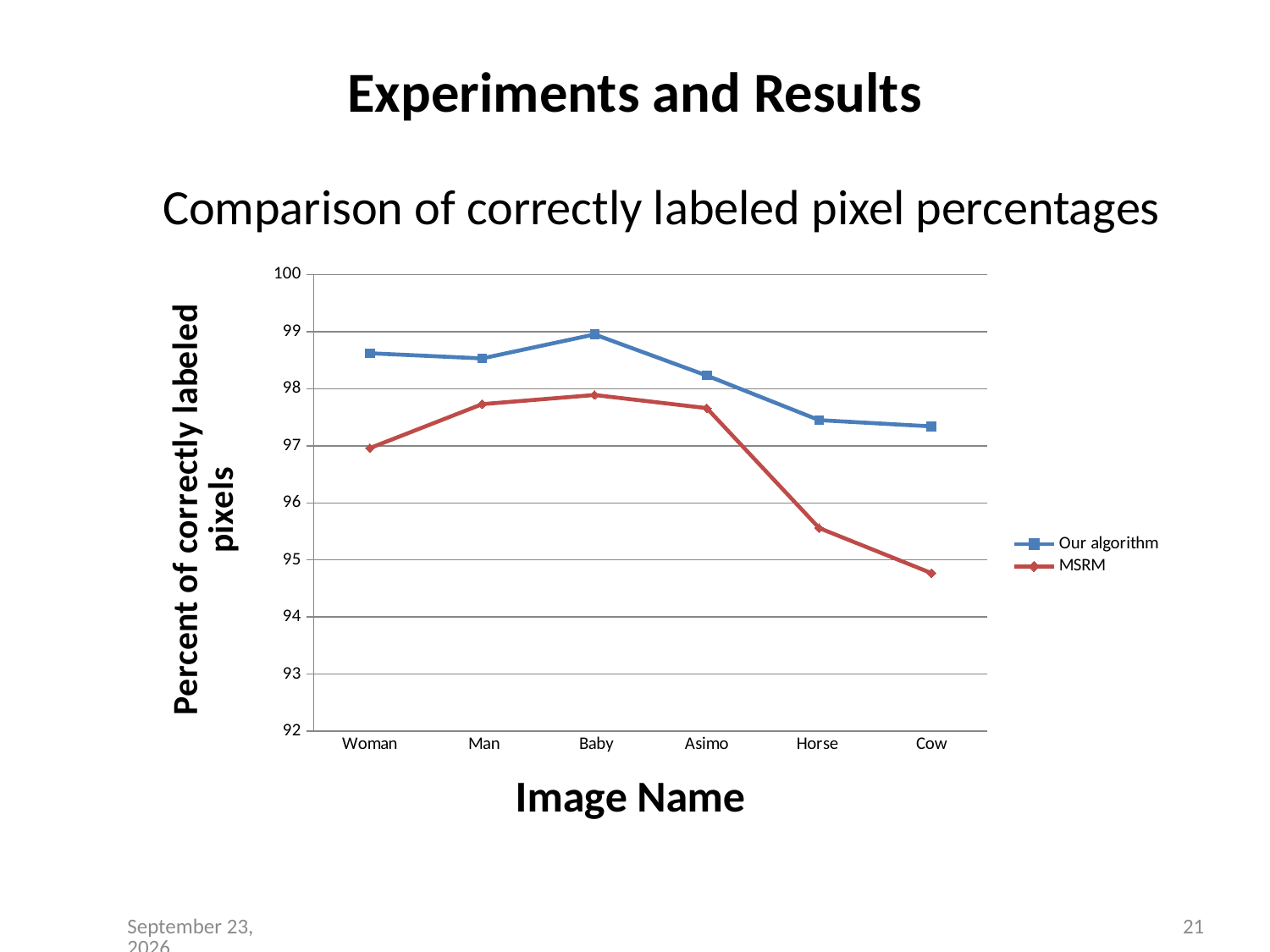
For which image does the Our algorithm series reach its highest value? Baby Is the MSRM value for Horse greater or less than 96? less What is the title of the x axis? Image Name Is the Our algorithm value for Baby greater or less than 98? greater What kind of chart is shown on the slide? Line chart How many image names are shown along the x axis? 6 Is the MSRM value for Cow greater or less than 95? less For which image does the MSRM series reach its highest value? Baby How many series does the legend list? 2 For which image does the MSRM series reach its lowest value? Cow Does the MSRM series rise or fall from Asimo to Cow? Fall For the Horse image, which series has the higher value, Our algorithm or MSRM? Our algorithm